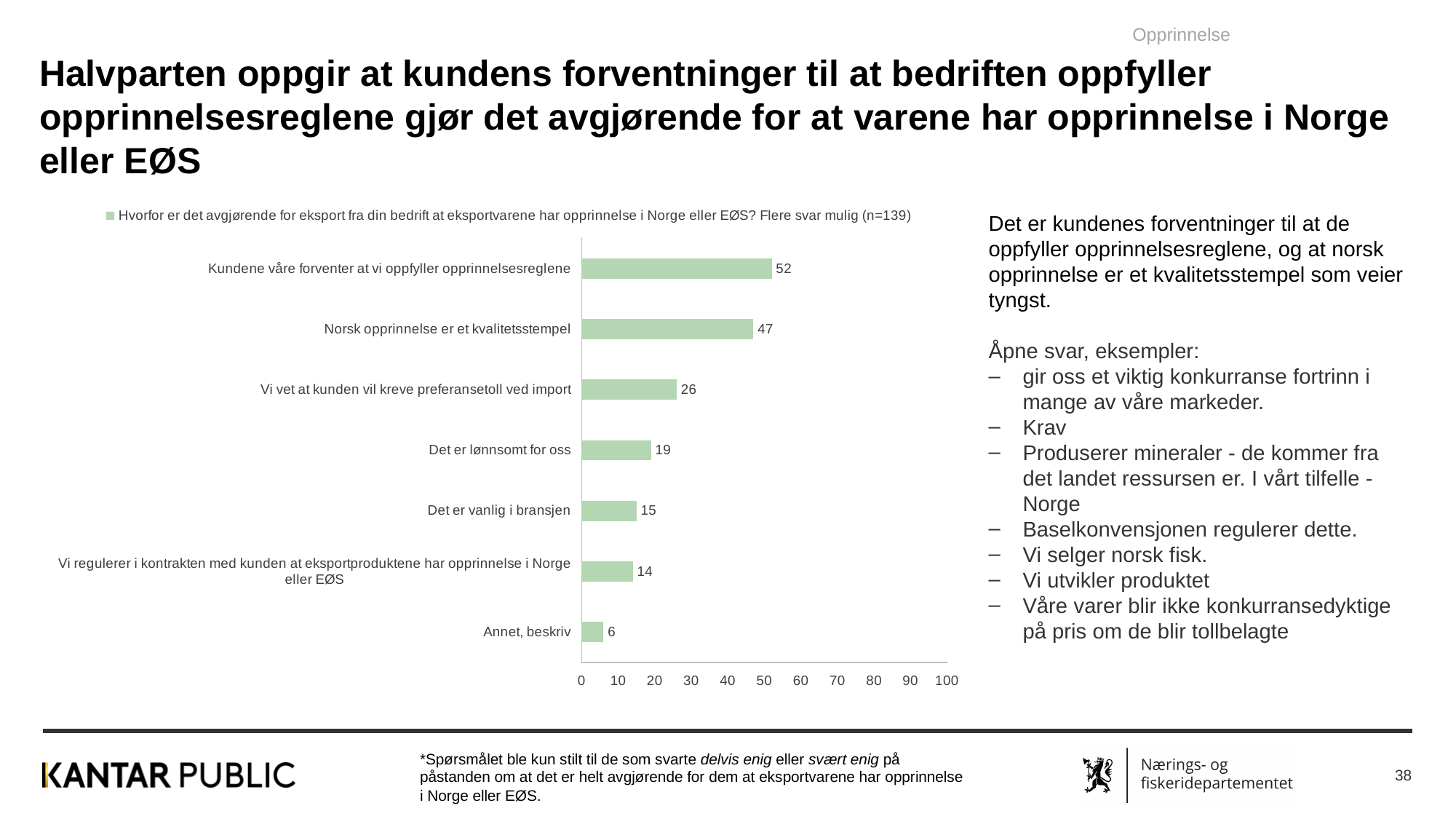
Which category has the lowest value? Annet, beskriv What is the value for "Det er lønnsomt for oss"? 19 What is the difference between the values for "Kundene våre forventer at vi oppfyller opprinnelsesreglene" and "Norsk opprinnelse er et kvalitetsstempel"? 5 What kind of chart is shown on the slide? bar chart What is the value for "Kundene våre forventer at vi oppfyller opprinnelsesreglene"? 52 Is the value for "Det er vanlig i bransjen" greater or less than 20? less How many categories are shown in the chart? 7 What is the value for "Norsk opprinnelse er et kvalitetsstempel"? 47 Which category has the highest value? Kundene våre forventer at vi oppfyller opprinnelsesreglene What is the maximum value shown on the x axis of the chart? 100 What is the value for "Annet, beskriv"? 6 Which is larger: the value for "Vi vet at kunden vil kreve preferansetoll ved import" or "Det er vanlig i bransjen"? Vi vet at kunden vil kreve preferansetoll ved import